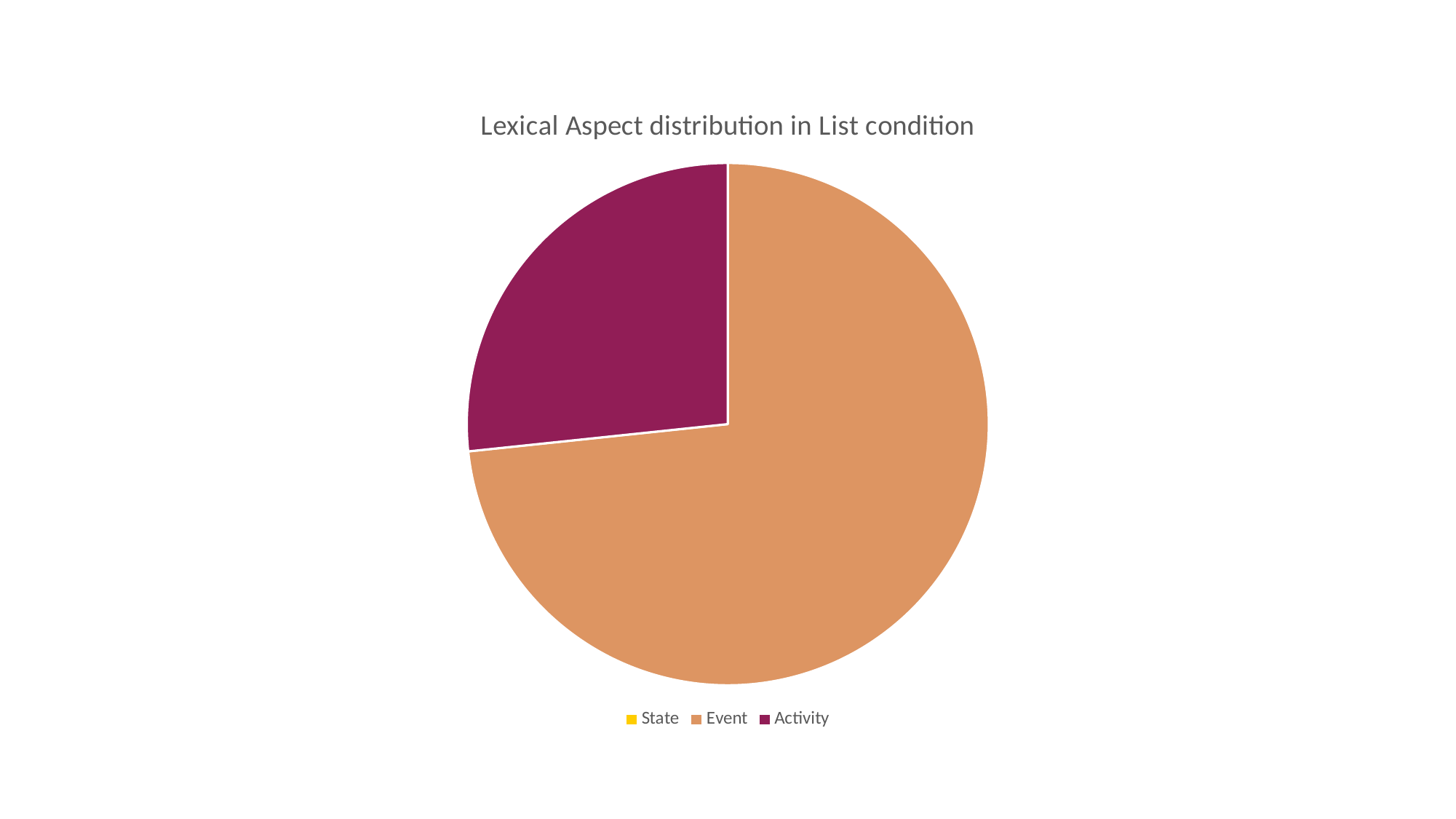
How many categories does the legend list? 3 Is the Event slice more or less than half of the pie? more Which category is listed first in the legend? State Which slice is larger, Event or Activity? Event Which category has the largest slice of the pie? Event What kind of chart is shown on the slide? Pie chart What is the title of the chart? Lexical Aspect distribution in List condition Is the Activity slice more or less than half of the pie? less Which colour represents the Activity category in the legend? Purple